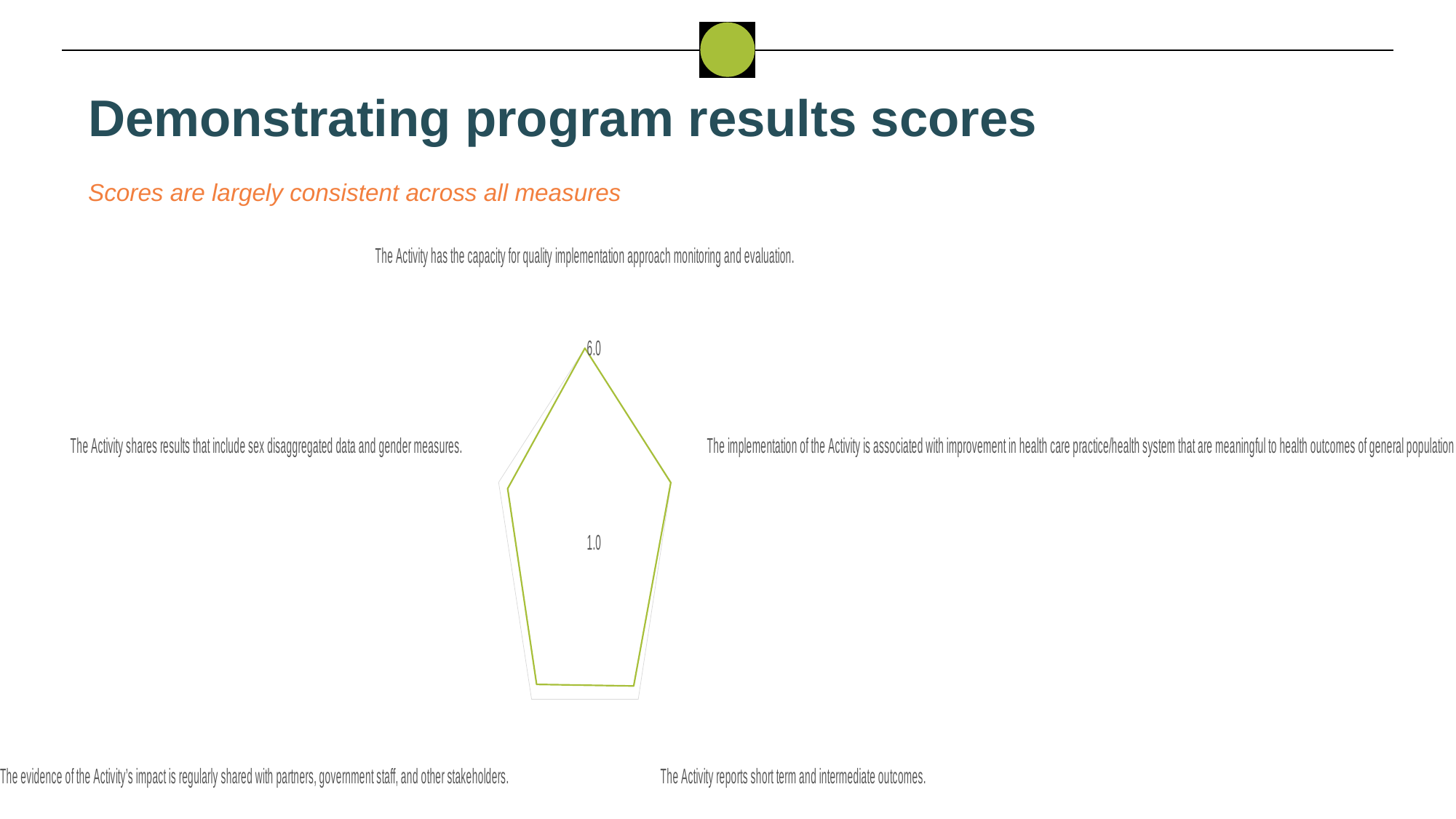
Is the value for 'The Activity has the capacity for quality implementation approach monitoring and evaluation.' greater or less than 1.0? greater Is the value for 'The Activity reports short term and intermediate outcomes.' greater or less than 1.0? greater What is the title of the slide containing the radar chart? Demonstrating program results scores What subtitle is shown above the radar chart? Scores are largely consistent across all measures What is the highest axis tick value printed on the radar chart? 6.0 How many categories (axes) does the radar chart have? 5 Is the value for 'The Activity shares results that include sex disaggregated data and gender measures.' greater or less than 1.0? greater What kind of chart is shown on the slide? radar chart